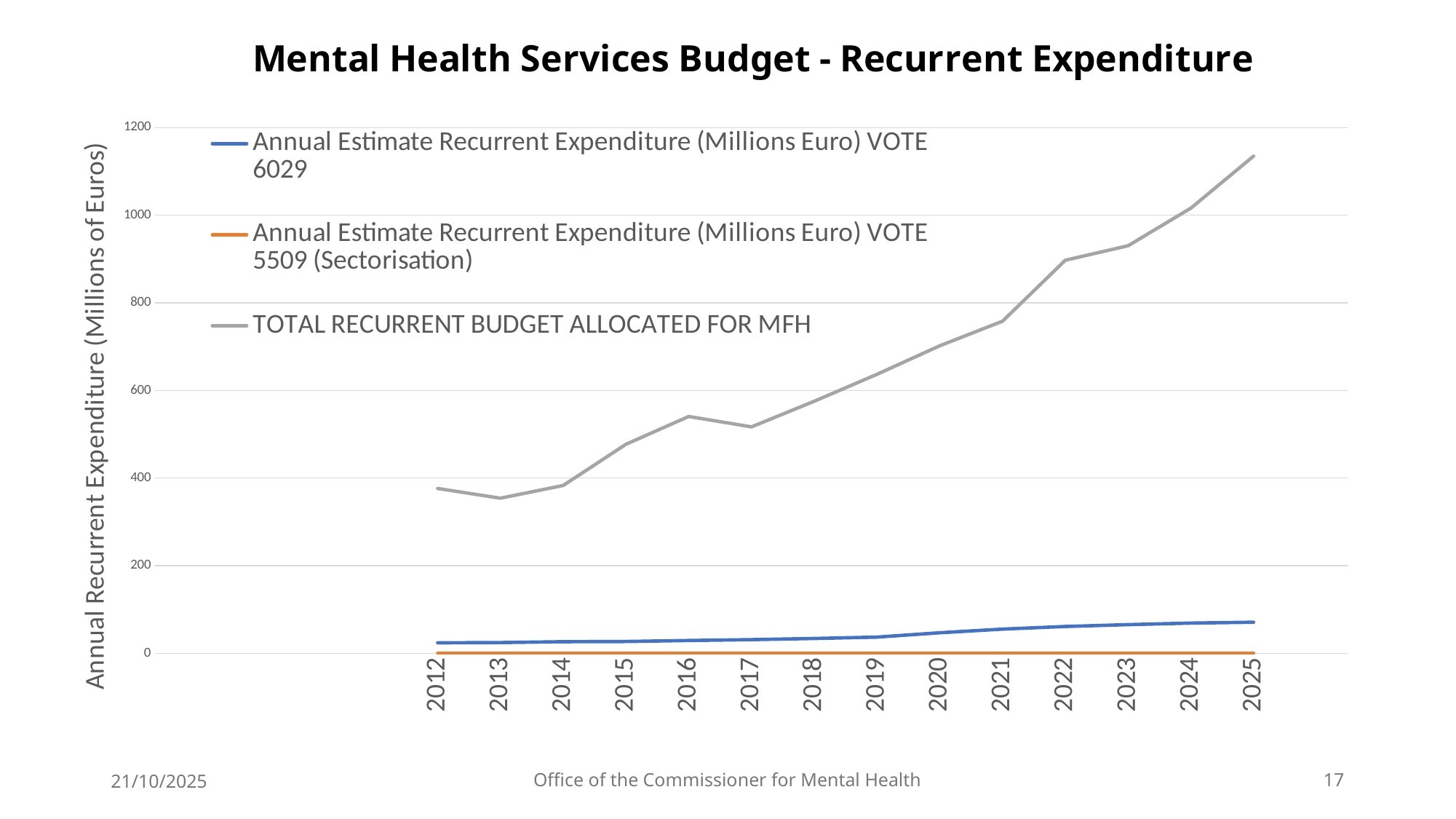
What is the title of the chart? Mental Health Services Budget - Recurrent Expenditure Which is larger in 2020: the TOTAL RECURRENT BUDGET ALLOCATED FOR MFH or the Annual Estimate Recurrent Expenditure VOTE 6029? TOTAL RECURRENT BUDGET ALLOCATED FOR MFH Does the TOTAL RECURRENT BUDGET ALLOCATED FOR MFH generally rise or fall from 2012 to 2025? Rise How many series does the legend list? 3 Is the TOTAL RECURRENT BUDGET ALLOCATED FOR MFH in 2025 greater or less than 1000? greater Is the TOTAL RECURRENT BUDGET ALLOCATED FOR MFH in 2021 greater or less than 800? less Is the TOTAL RECURRENT BUDGET ALLOCATED FOR MFH in 2012 greater or less than 400? less How many years are plotted along the x axis? 14 What kind of chart is shown on the slide? Line chart In which year is the TOTAL RECURRENT BUDGET ALLOCATED FOR MFH highest? 2025 In which year is the TOTAL RECURRENT BUDGET ALLOCATED FOR MFH lowest? 2013